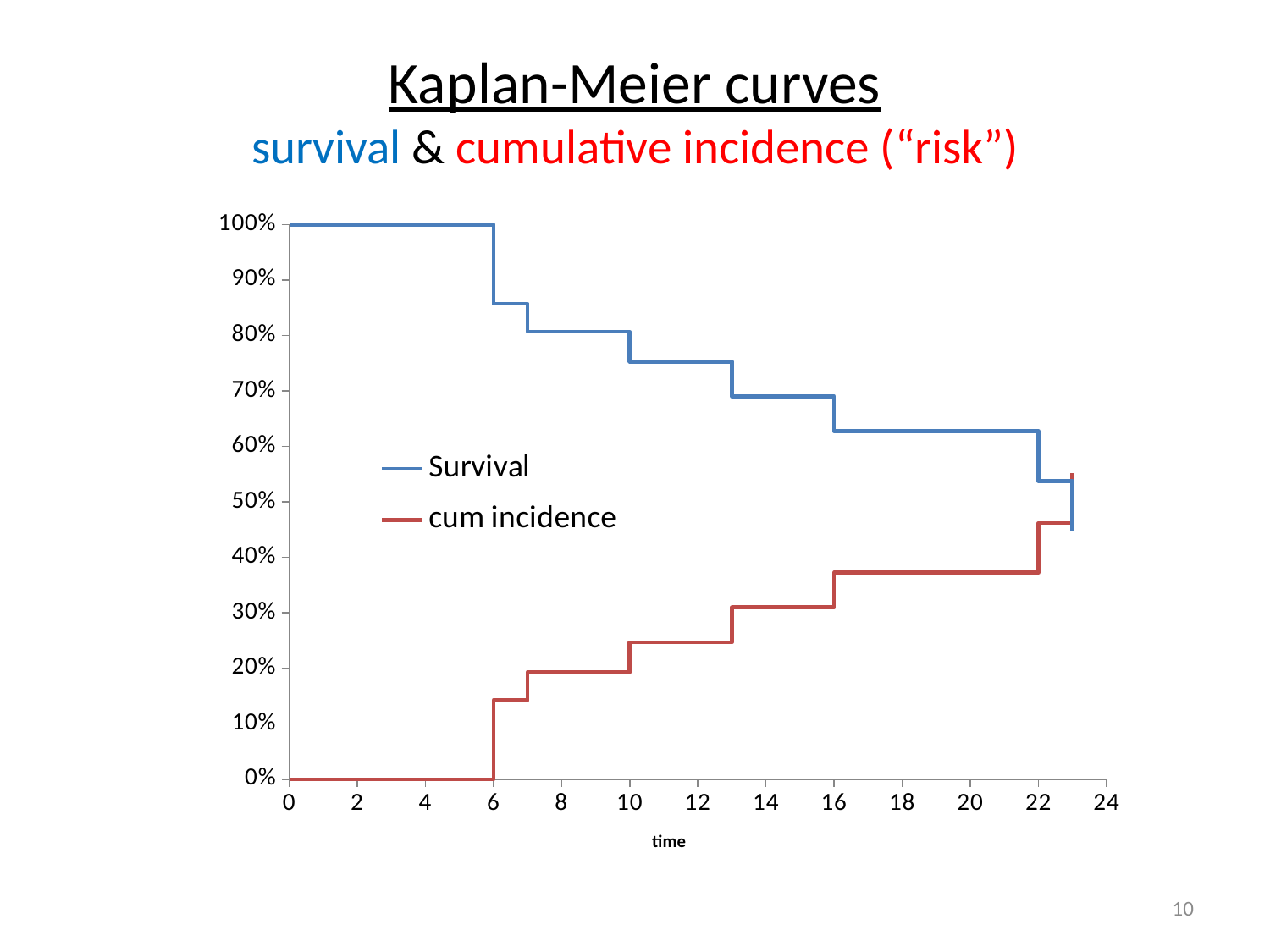
Is the value of the Survival series at time 20 greater or less than 60%? greater At time 12, which series has the larger value, Survival or cum incidence? Survival What is the value of the Survival series at time 0? 100% What is the title of the x axis? time What is the value of the cum incidence series at time 0? 0% What type of chart is shown on the slide? line chart Is the value of the cum incidence series at time 20 greater or less than 40%? less Does the cum incidence series rise or fall as time increases? rise Is the value of the Survival series at time 12 greater or less than 80%? less At what time does the Survival curve first drop below 100%? 6 Does the Survival series rise or fall as time increases? fall How many series does the legend list? 2